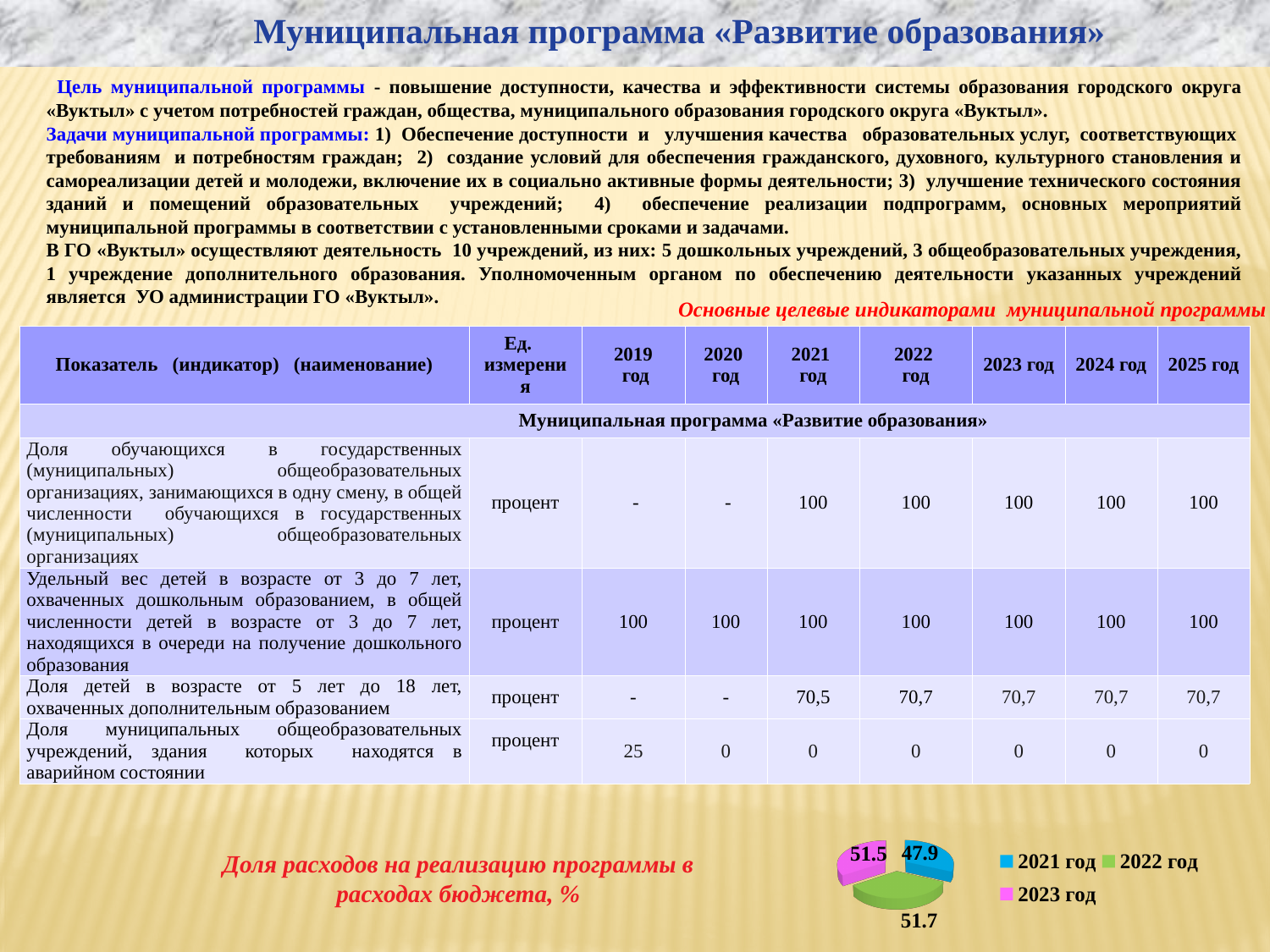
What is the largest value labelled on the pie chart? 51.7 How many slices does the pie chart have? 3 On the pie chart, is the value for 2022 год greater or less than 50? greater On the pie chart, what is the value for 2022 год? 51.7 What is the difference between the largest and smallest values labelled on the pie chart? 3.8 On the pie chart, what is the value for 2021 год? 47.9 How many entries does the legend of the pie chart list? 3 Which years are listed in the legend of the pie chart? 2021 год, 2022 год, 2023 год What kind of chart is shown at the bottom of the slide? pie chart What is the title of the pie chart? Доля расходов на реализацию программы в расходах бюджета, % On the pie chart, which is larger: the value 51.5 or the value 47.9? 51.5 What is the smallest value labelled on the pie chart? 47.9